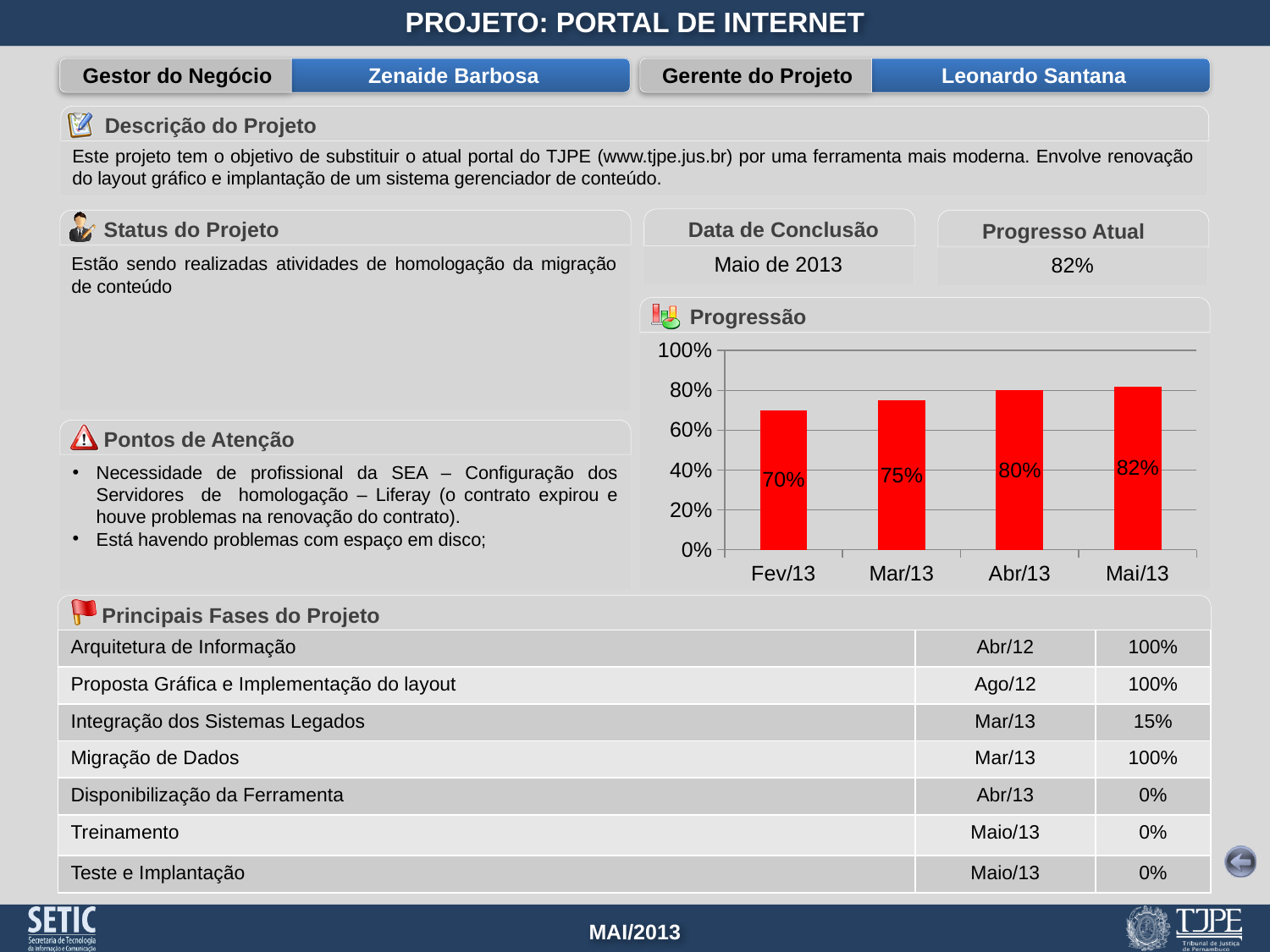
Do the values in the Progressão chart rise or fall from Fev/13 to Mai/13? rise What is the value for Fev/13 in the Progressão chart? 70% How many months are shown on the x axis of the Progressão chart? 4 Is the value for Fev/13 in the Progressão chart greater or less than 60%? greater What is the value for Mar/13 in the Progressão chart? 75% What is the value for Abr/13 in the Progressão chart? 80% What is the value for Mai/13 in the Progressão chart? 82% What is the difference between the values for Mai/13 and Fev/13 in the Progressão chart? 12% What kind of chart is the Progressão chart? bar chart Which month has the lowest value in the Progressão chart? Fev/13 Which month has the highest value in the Progressão chart? Mai/13 Which is larger in the Progressão chart, the value for Mar/13 or the value for Abr/13? Abr/13